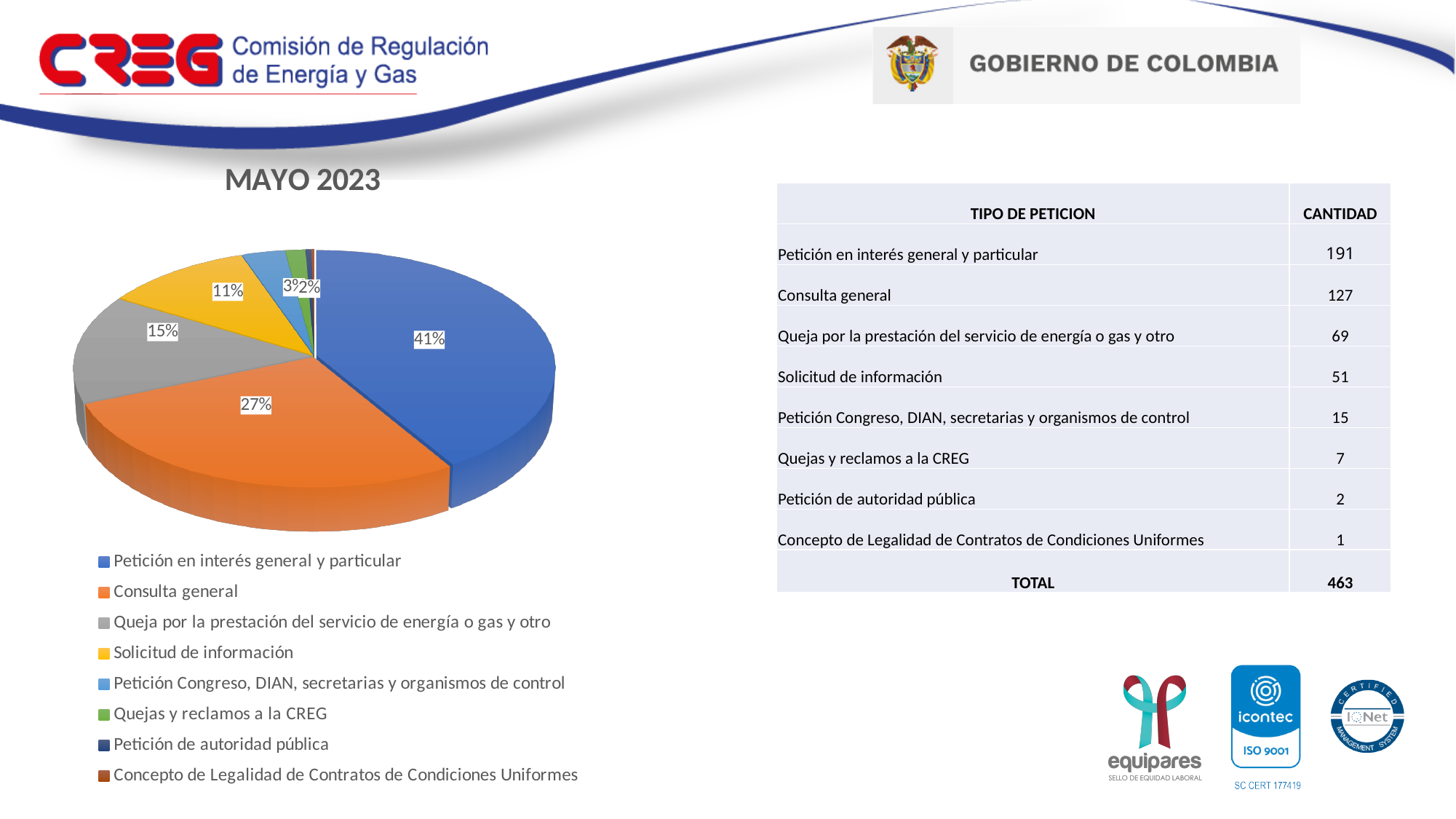
What kind of chart is shown on the slide? pie chart What colour is the slice for 'Consulta general' in the pie chart? orange What share of the pie does 'Queja por la prestación del servicio de energía o gas y otro' represent? 15% What share of the pie does 'Consulta general' represent? 27% What share of the pie does 'Solicitud de información' represent? 11% What is the title of the pie chart? MAYO 2023 How many categories does the pie chart's legend list? 8 Which slice is larger: 'Queja por la prestación del servicio de energía o gas y otro' or 'Solicitud de información'? Queja por la prestación del servicio de energía o gas y otro What is the difference in percentage points between the 'Petición en interés general y particular' slice and the 'Consulta general' slice? 14% Which category has the largest slice of the pie chart? Petición en interés general y particular Which slice is larger: 'Consulta general' or 'Solicitud de información'? Consulta general